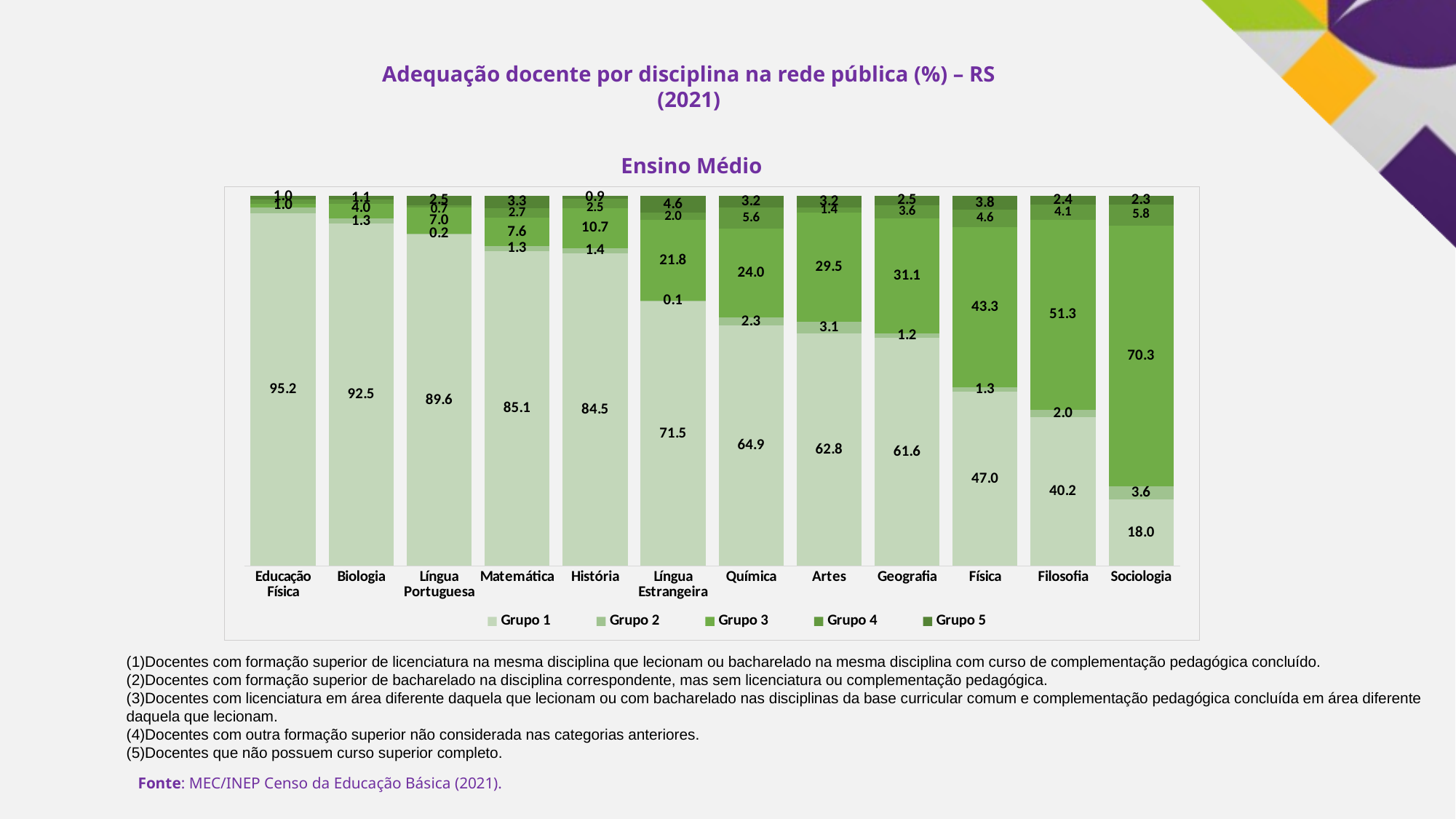
What is the Grupo 1 value for Língua Estrangeira? 71.5 What kind of chart is shown? Stacked bar chart Do the Grupo 1 values rise or fall from left to right along the x axis? Fall What is the difference between the Grupo 1 values for Física and Filosofia? 6.8 Which discipline has the lowest Grupo 1 value? Sociologia Which has the larger Grupo 3 value, Química or Artes? Artes Which discipline has the highest Grupo 3 value? Sociologia What is the Grupo 1 value for Sociologia? 18.0 How many disciplines are shown on the x axis? 12 Which discipline has the highest Grupo 1 value? Educação Física How many series does the legend list? 5 What is the Grupo 3 value for Filosofia? 51.3